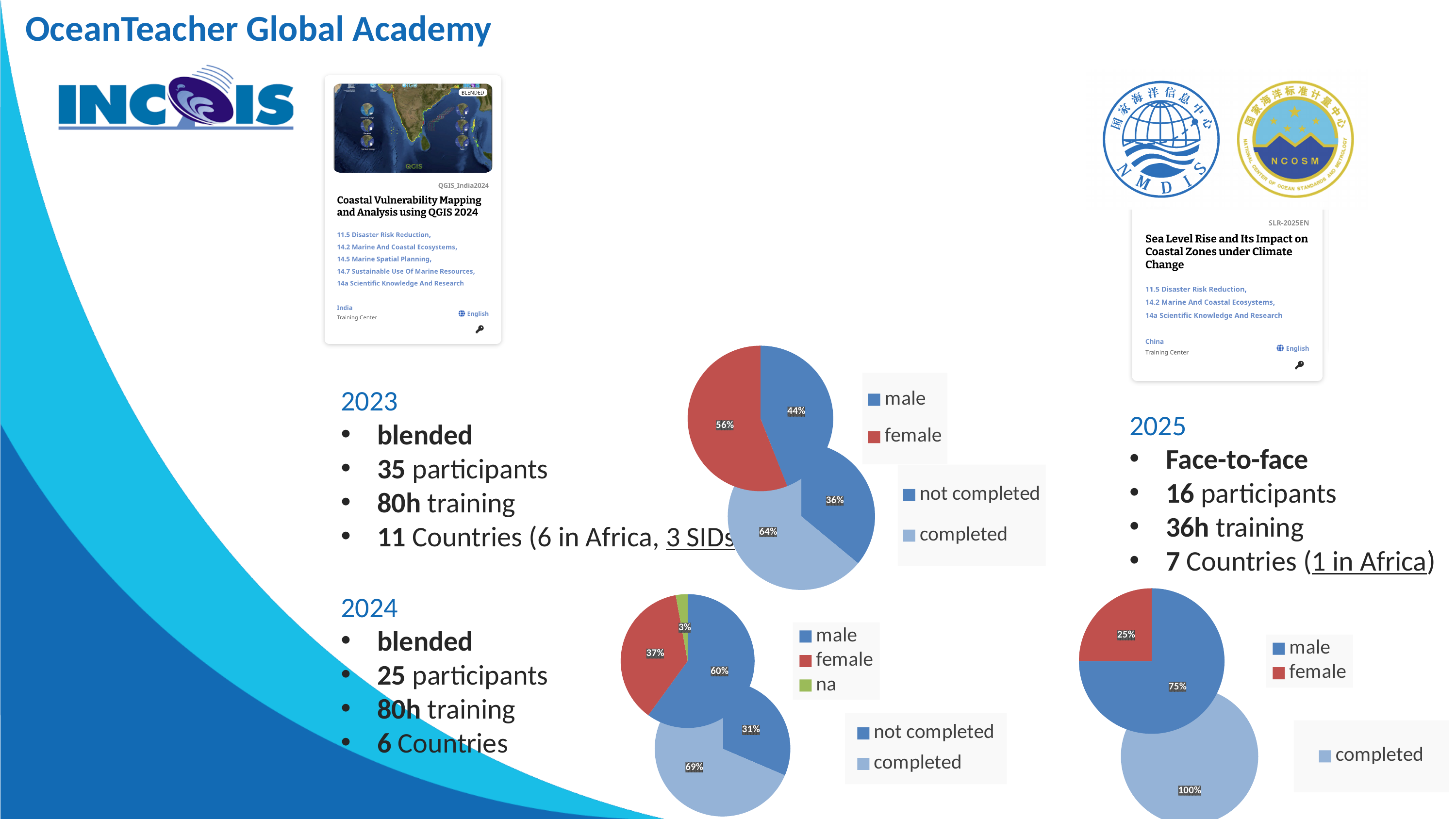
In the 2023 gender pie chart (upper pie next to the 2023 text), what share is male? 44% In the 2023 completion pie chart (lower pie next to the 2023 text), what is the difference between the completed and not completed shares? 28% In the 2025 gender pie chart (upper pie next to the 2025 text), which is larger, male or female? male In the 2024 gender pie chart (upper pie next to the 2024 text), which category has the largest share? male In the 2024 gender pie chart (upper pie next to the 2024 text), how many categories does the legend list? 3 In the 2023 completion pie chart (lower pie next to the 2023 text), what share is completed? 64% In the 2024 gender pie chart (upper pie next to the 2024 text), what share is labelled na? 3% In the 2025 gender pie chart (upper pie next to the 2025 text), what share is male? 75% In the 2023 gender pie chart (upper pie next to the 2023 text), what share is female? 56% What type of chart is used to show the gender split for 2023? pie chart In the 2024 completion pie chart (lower pie next to the 2024 text), what share is not completed? 31% In the 2025 completion pie chart (bottom right pie), what share is completed? 100%